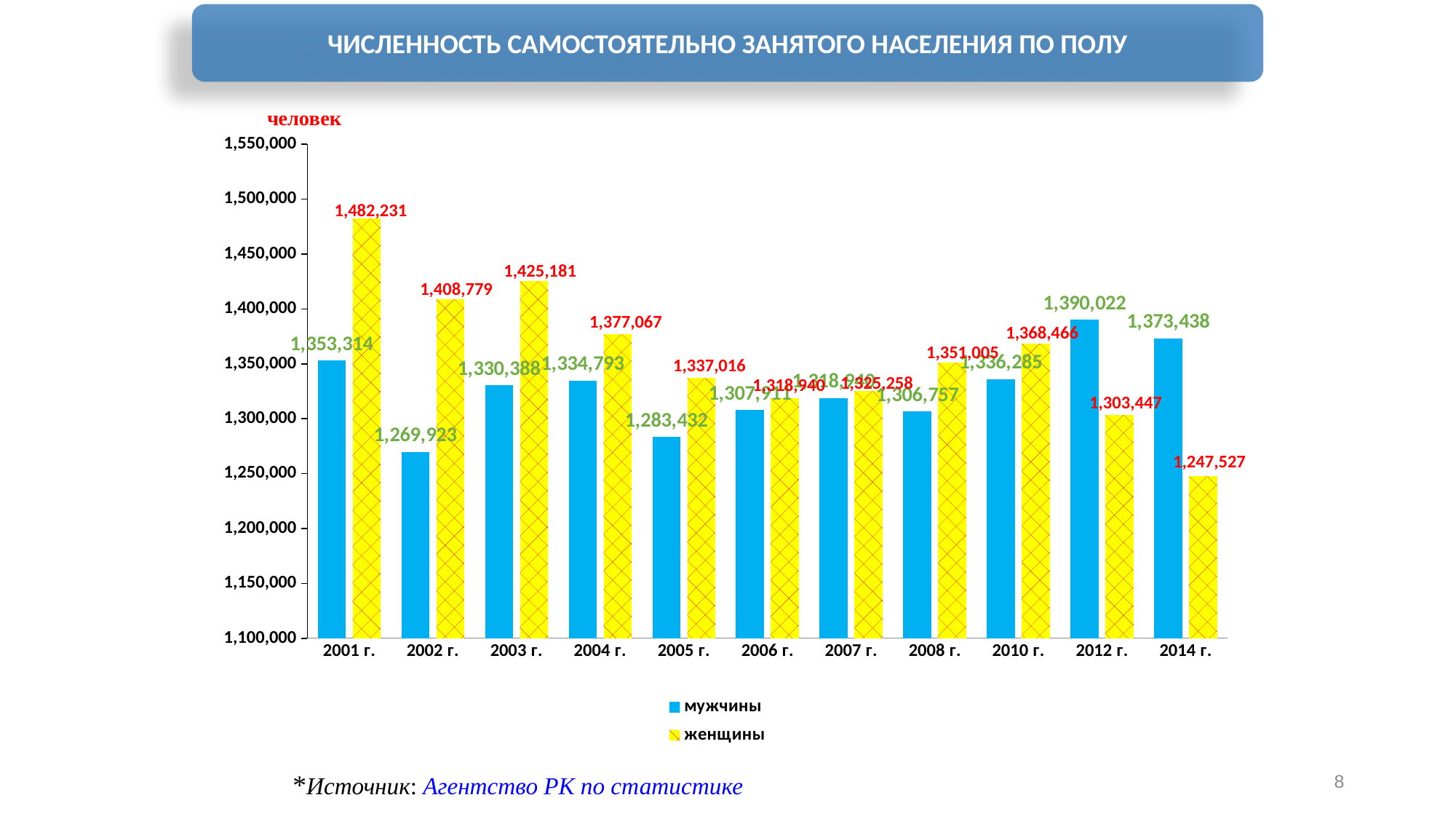
What is the value for женщины in 2001 г.? 1,482,231 In which year is the value for женщины the highest? 2001 г. How many series does the legend list? 2 How many years are shown on the x axis? 11 In which year is the value for женщины the lowest? 2014 г. In which year is the value for мужчины the lowest? 2002 г. Is the value for мужчины in 2005 г. greater or less than 1,300,000? less What is the value for женщины in 2003 г.? 1,425,181 In 2012 г., which series has the larger value, мужчины or женщины? мужчины What is the difference between мужчины and женщины in 2014 г.? 125,911 What is the value for мужчины in 2012 г.? 1,390,022 What kind of chart is shown on the slide? bar chart